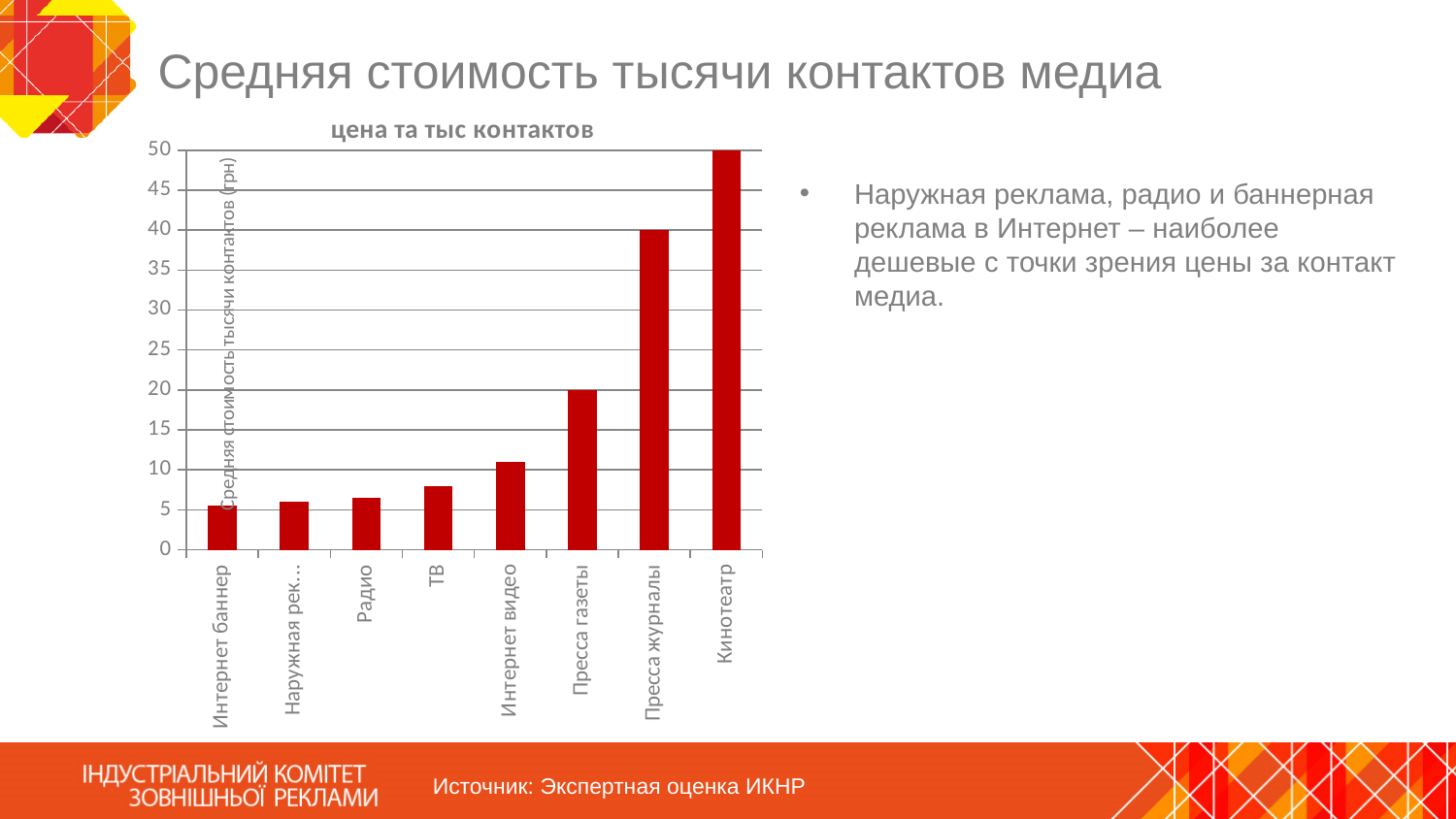
Is the value for Интернет видео greater or less than 10? greater Which category has the highest value in the chart? Кинотеатр Which is larger, the value for Пресса газеты or the value for Интернет видео? Пресса газеты What is the value for Пресса журналы? 40 What is the value for Пресса газеты? 20 How many categories are plotted on the x axis of the chart? 8 Do the values rise or fall moving from left to right along the x axis? rise What kind of chart is shown on the slide? bar chart What is the title of the chart? цена та тыс контактов Is the value for ТВ greater or less than 10? less